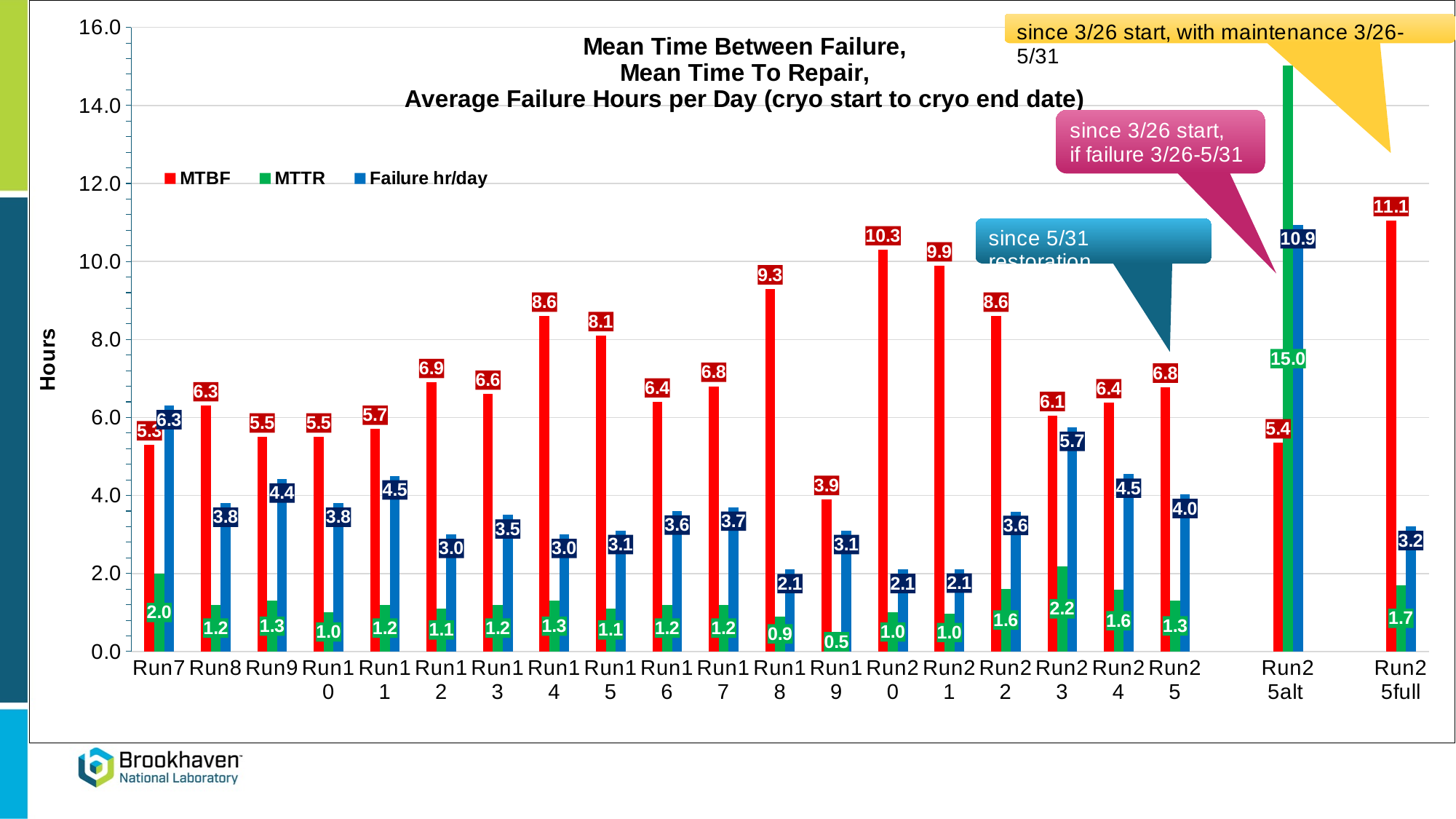
What is the Failure hr/day value for Run23? 5.7 What kind of chart is shown on the slide? Bar chart How many series does the legend list? 3 How many runs (categories) are shown on the x axis? 21 Which run has the lowest MTBF value? Run19 Which run has the highest MTBF value? Run25full What is the MTBF value for Run20? 10.3 What is the MTTR value for Run25alt? 15.0 Which run has the highest Failure hr/day value? Run25alt Which is larger, the MTBF for Run18 or the MTBF for Run21? Run21 What is the difference between the MTBF values for Run25full and Run25alt? 5.7 Which series is shown in green in the legend? MTTR